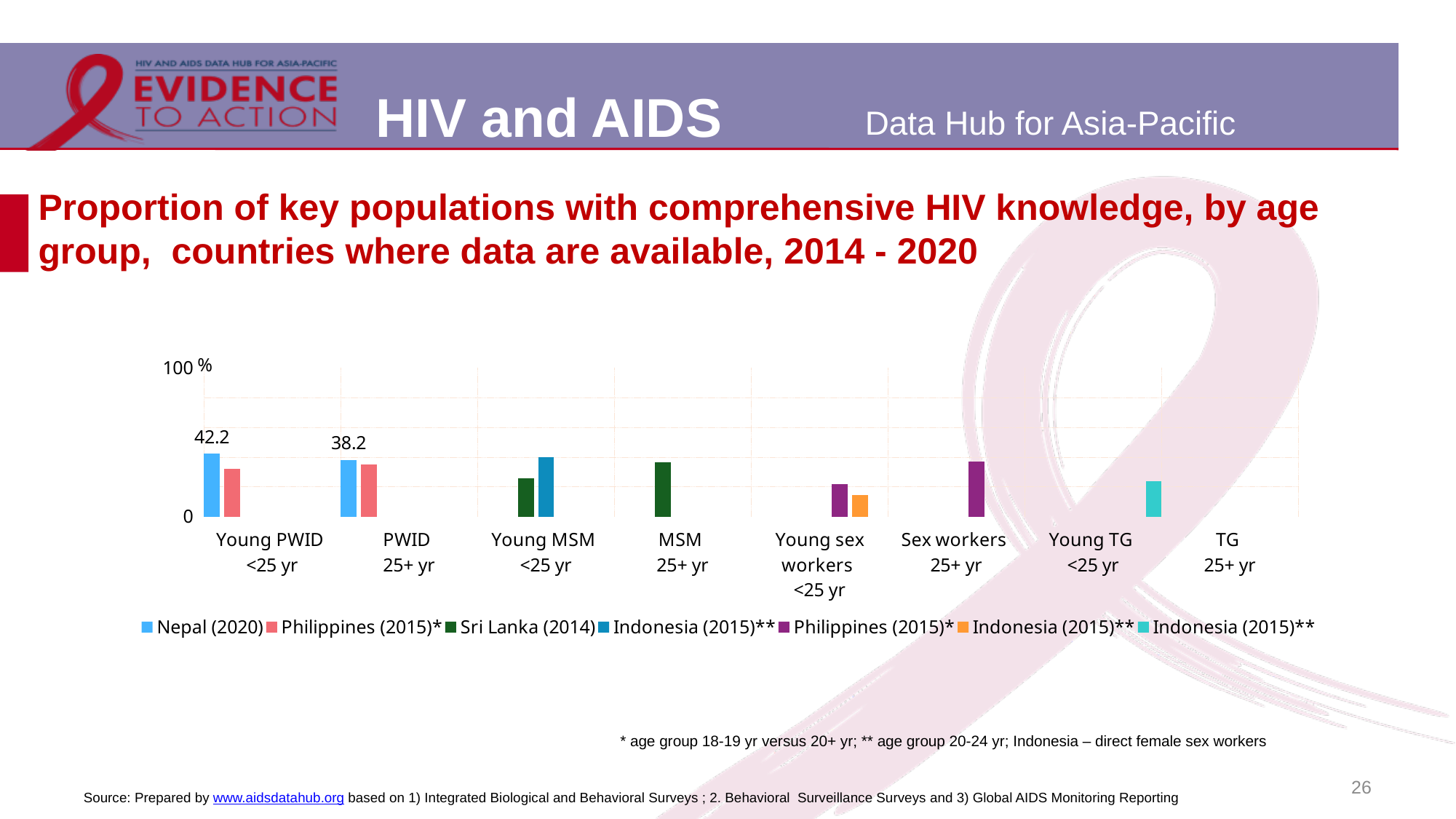
In the Young PWID <25 yr category, which series has the taller bar: Nepal (2020) or Philippines (2015)*? Nepal (2020) Which country and year is represented by the light blue bars in the legend? Nepal (2020) What is the difference between the Nepal (2020) values for Young PWID <25 yr and PWID 25+ yr? 4.0 What is the maximum value shown on the y axis? 100 How many series entries does the legend list? 7 How many population/age-group categories are shown on the x axis? 8 What kind of chart is shown on the slide? Bar chart In the Young MSM <25 yr category, which series has the taller bar: Sri Lanka (2014) or Indonesia (2015)**? Indonesia (2015)** In the Young sex workers <25 yr category, which series has the taller bar: Philippines (2015)* or Indonesia (2015)**? Philippines (2015)* What is the value for Nepal (2020) in the PWID 25+ yr category? 38.2 What is the value for Nepal (2020) in the Young PWID <25 yr category? 42.2